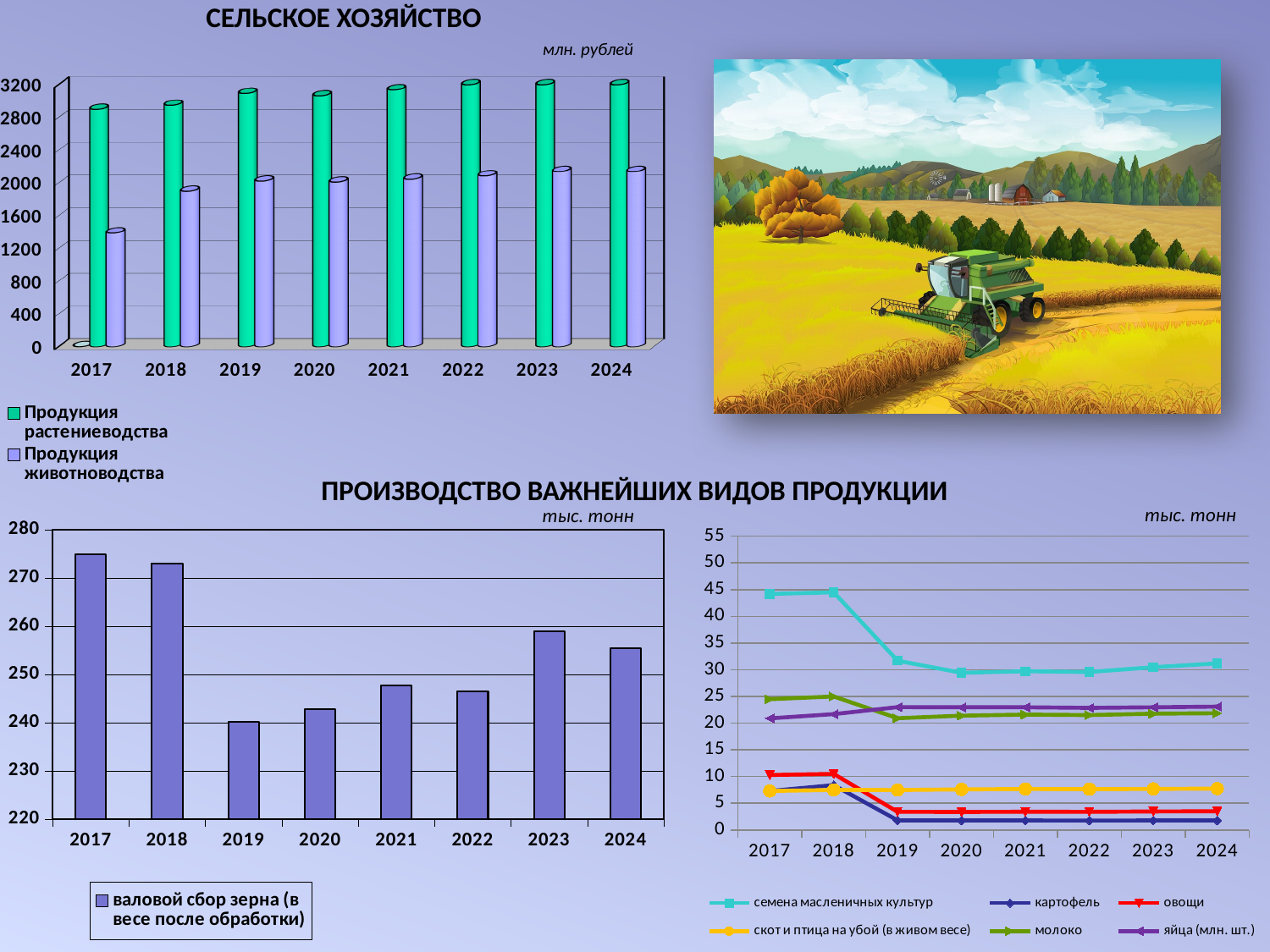
In the bottom-right line chart, how many series does the legend list? 6 In the top-left chart titled 'СЕЛЬСКОЕ ХОЗЯЙСТВО', which series has the larger value in 2024, 'Продукция растениеводства' or 'Продукция животноводства'? Продукция растениеводства In the top-left chart titled 'СЕЛЬСКОЕ ХОЗЯЙСТВО', how many series does the legend list? 2 In the bottom-left bar chart of 'валовой сбор зерна', which year has the lowest value? 2019 In the bottom-left bar chart of 'валовой сбор зерна', how many years are shown on the x axis? 8 In the top-left chart titled 'СЕЛЬСКОЕ ХОЗЯЙСТВО', what unit is shown above the chart? млн. рублей In the bottom-left bar chart of 'валовой сбор зерна', which year has the highest value? 2017 In the bottom-right line chart, does the value for 'семена масленичных культур' rise or fall from 2017 to 2024? fall In the bottom-right line chart, is the 2017 value for 'семена масленичных культур' greater or less than 40? greater In the bottom-left bar chart of 'валовой сбор зерна', is the value for 2019 greater or less than 250? less In the top-left chart titled 'СЕЛЬСКОЕ ХОЗЯЙСТВО', is the 2017 value for 'Продукция животноводства' greater or less than 1600? less In the top-left chart titled 'СЕЛЬСКОЕ ХОЗЯЙСТВО', which year has the lowest value for 'Продукция животноводства'? 2017